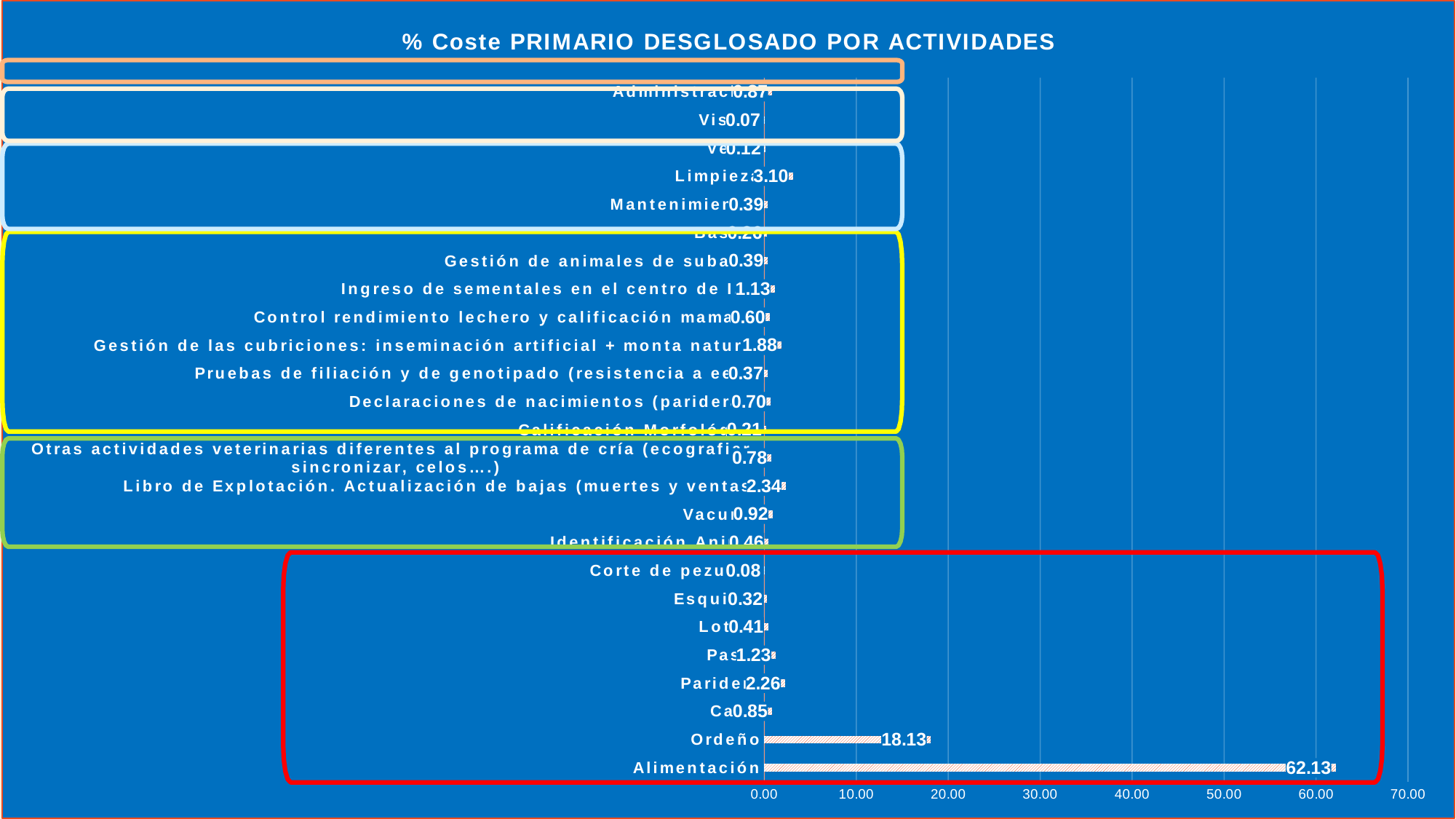
Which activity has the highest value in the chart? Alimentación What is the value for Ordeño? 18.13 What is the title of the chart? % Coste PRIMARIO DESGLOSADO POR ACTIVIDADES What type of chart is shown on the slide? bar chart What is the value for 'Otras actividades veterinarias diferentes al programa de cría (ecografías, sincronizar, celos....)'? 0.78 Which is larger, the value for Ordeño or the value for Alimentación? Alimentación Is the value for Alimentación greater or less than 60.00? greater What is the highest value shown on the horizontal axis? 70.00 What is the difference between the values for Alimentación and Ordeño? 44.00 Is the value for Ordeño greater or less than 20.00? less What is the value for 'Libro de Explotación. Actualización de bajas (muertes y ventas)'? 2.34 What is the value for Alimentación? 62.13